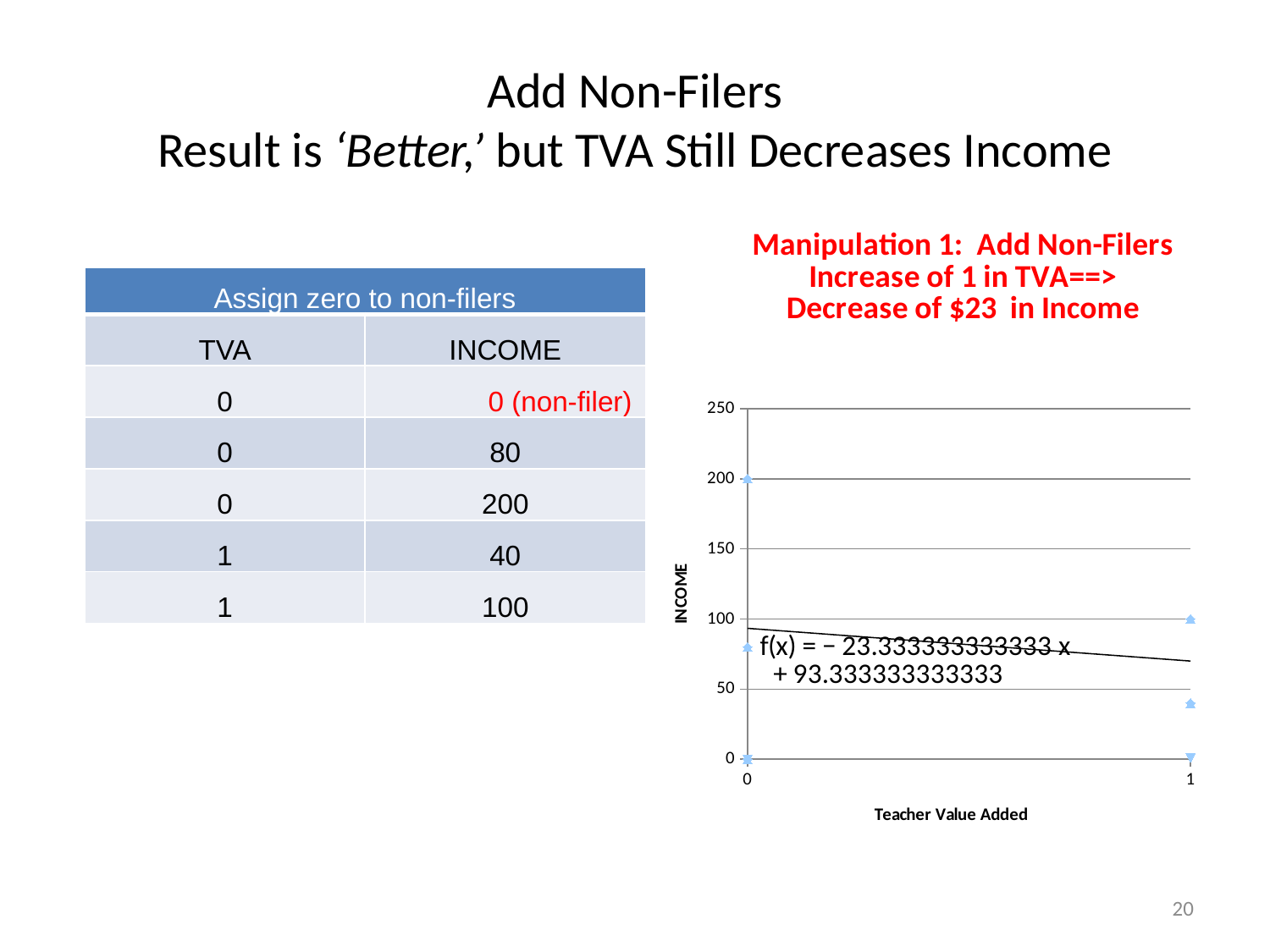
What is the maximum value shown on the INCOME axis of the chart? 250 How many distinct Teacher Value Added values are labelled on the x axis of the chart? 2 What is the highest INCOME value plotted on the chart? 200 What kind of chart is shown on the right side of the slide? scatter chart What is the highest INCOME value plotted at Teacher Value Added 1? 100 Is the lower plotted INCOME point at Teacher Value Added 1 greater or less than 50? less Is the highest plotted point at Teacher Value Added 0 larger or smaller than the highest plotted point at Teacher Value Added 1? larger Does the trendline on the chart rise or fall as Teacher Value Added increases from 0 to 1? fall What is the title of the x axis of the chart? Teacher Value Added What equation is printed for the trendline on the chart? f(x) = − 23.333333333333 x + 93.333333333333 Is the middle plotted INCOME point at Teacher Value Added 0 greater or less than 100? less At which Teacher Value Added does the highest plotted INCOME point occur? 0